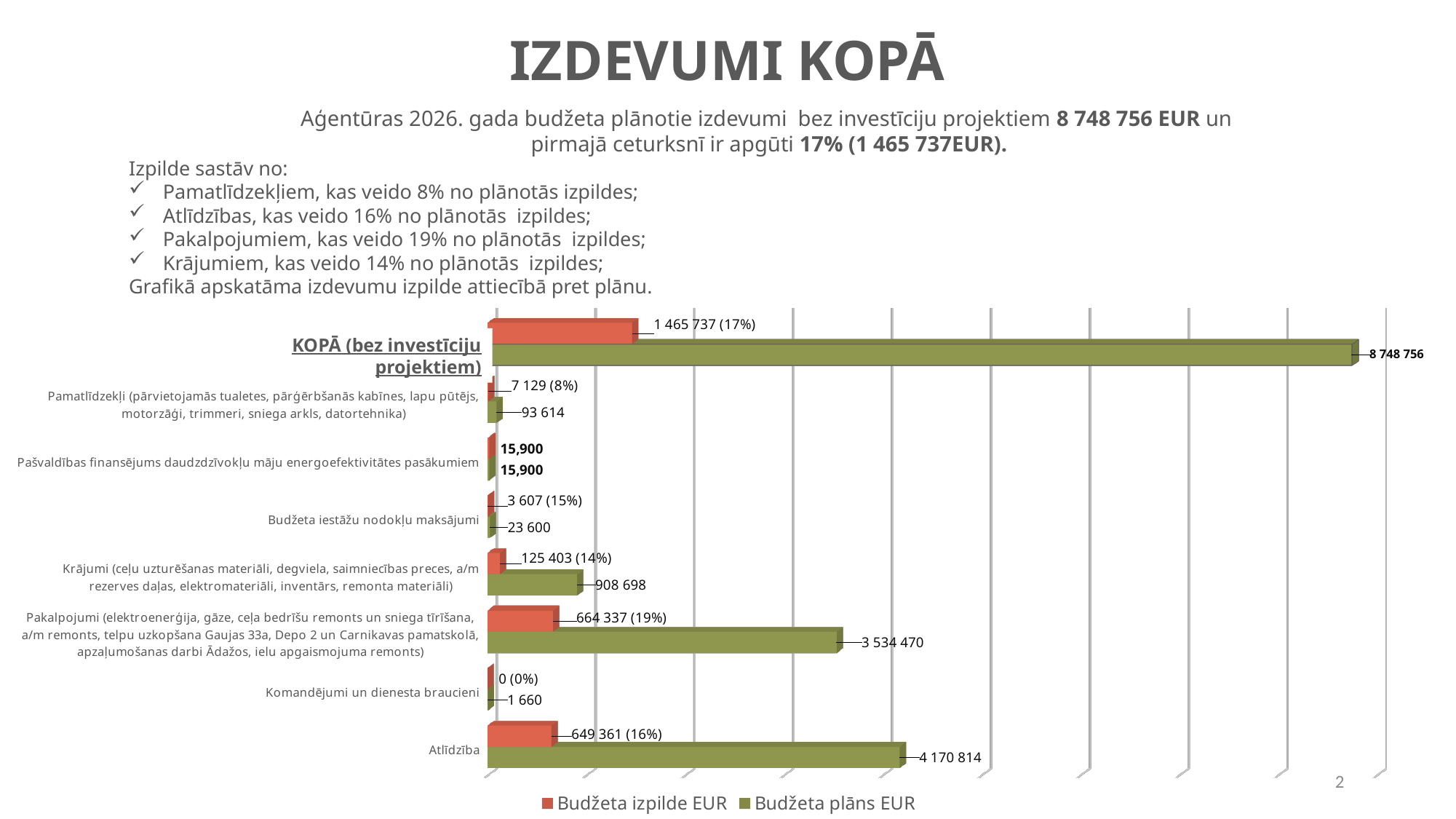
What is the difference between the Budžeta plāns EUR and Budžeta izpilde EUR values for Krājumi? 783 295 What is the Budžeta plāns EUR value for KOPĀ (bez investīciju projektiem)? 8 748 756 What is the Budžeta izpilde EUR value for Atlīdzība? 649 361 (16%) Which is larger, the Budžeta plāns EUR value for Atlīdzība or for Pakalpojumi? Atlīdzība How many series does the chart legend list? 2 Which category has the lowest Budžeta plāns EUR value? Komandējumi un dienesta braucieni What is the Budžeta izpilde EUR value for Krājumi? 125 403 (14%) How many categories are plotted on the chart? 8 What kind of chart is shown on the slide? bar chart Which series is shown in red on the chart? Budžeta izpilde EUR What is the Budžeta plāns EUR value for Pakalpojumi? 3 534 470 Which category has the highest Budžeta plāns EUR value? KOPĀ (bez investīciju projektiem)